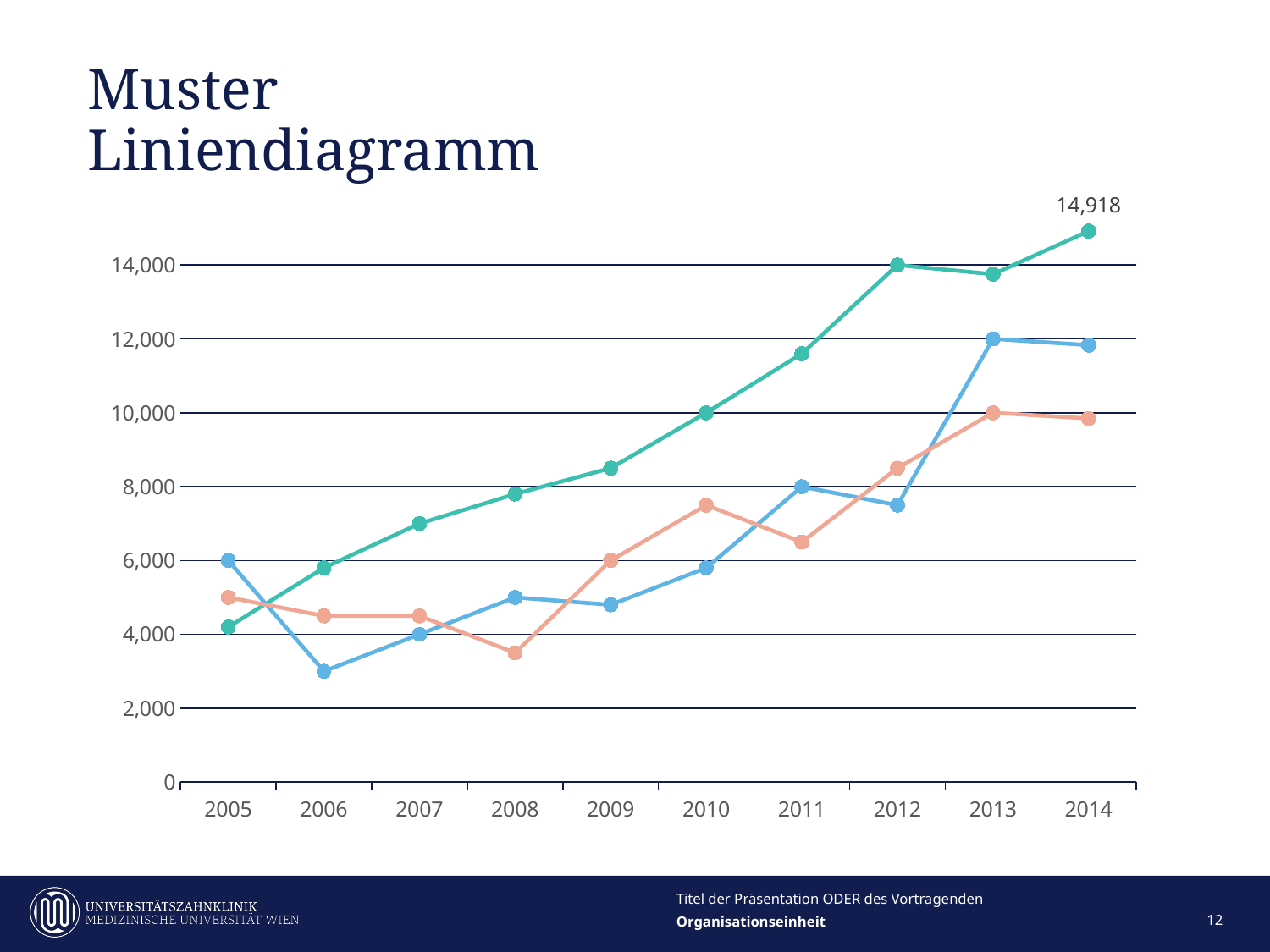
What kind of chart is shown on the slide? line chart How many lines are plotted on the chart? 3 In 2012, which line has the higher value, the orange line or the blue line? orange In 2014, which line has the higher value, the green line or the blue line? green Is the value of the orange line in 2008 greater or less than 4,000? less What is the value of the green line in 2014? 14,918 How many years are shown on the x axis of the chart? 10 Is the value of the blue line in 2006 greater or less than 4,000? less Is the value of the green line in 2011 greater or less than 10,000? greater Does the green line generally rise or fall from 2005 to 2014? rise In which year does the blue line reach its lowest value? 2006 In which year does the green line reach its highest value? 2014